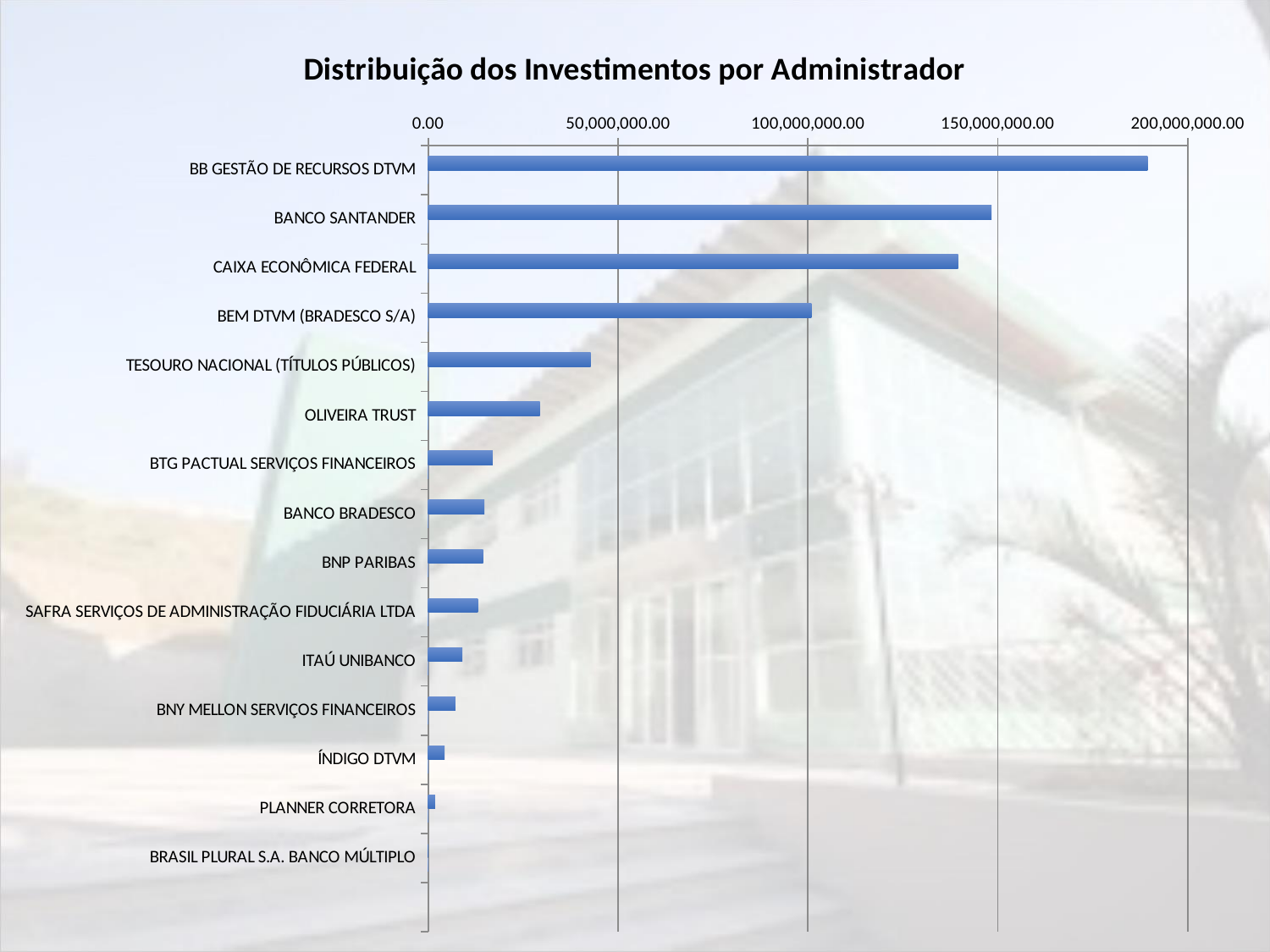
Is the value for CAIXA ECONÔMICA FEDERAL greater or less than 150,000,000.00? less Is the value for TESOURO NACIONAL (TÍTULOS PÚBLICOS) greater or less than 50,000,000.00? less What type of chart is shown on the slide? Bar chart Which administrator has the lowest investment value? BRASIL PLURAL S.A. BANCO MÚLTIPLO Is the value for BB GESTÃO DE RECURSOS DTVM greater or less than 150,000,000.00? greater Which administrator has the highest investment value? BB GESTÃO DE RECURSOS DTVM Do the bar values increase or decrease going from the top of the chart to the bottom? decrease How many administrators (categories) are listed on the chart? 15 Which has a larger value, TESOURO NACIONAL (TÍTULOS PÚBLICOS) or OLIVEIRA TRUST? TESOURO NACIONAL (TÍTULOS PÚBLICOS) What is the title of the chart? Distribuição dos Investimentos por Administrador Which has a larger value, BANCO SANTANDER or CAIXA ECONÔMICA FEDERAL? BANCO SANTANDER